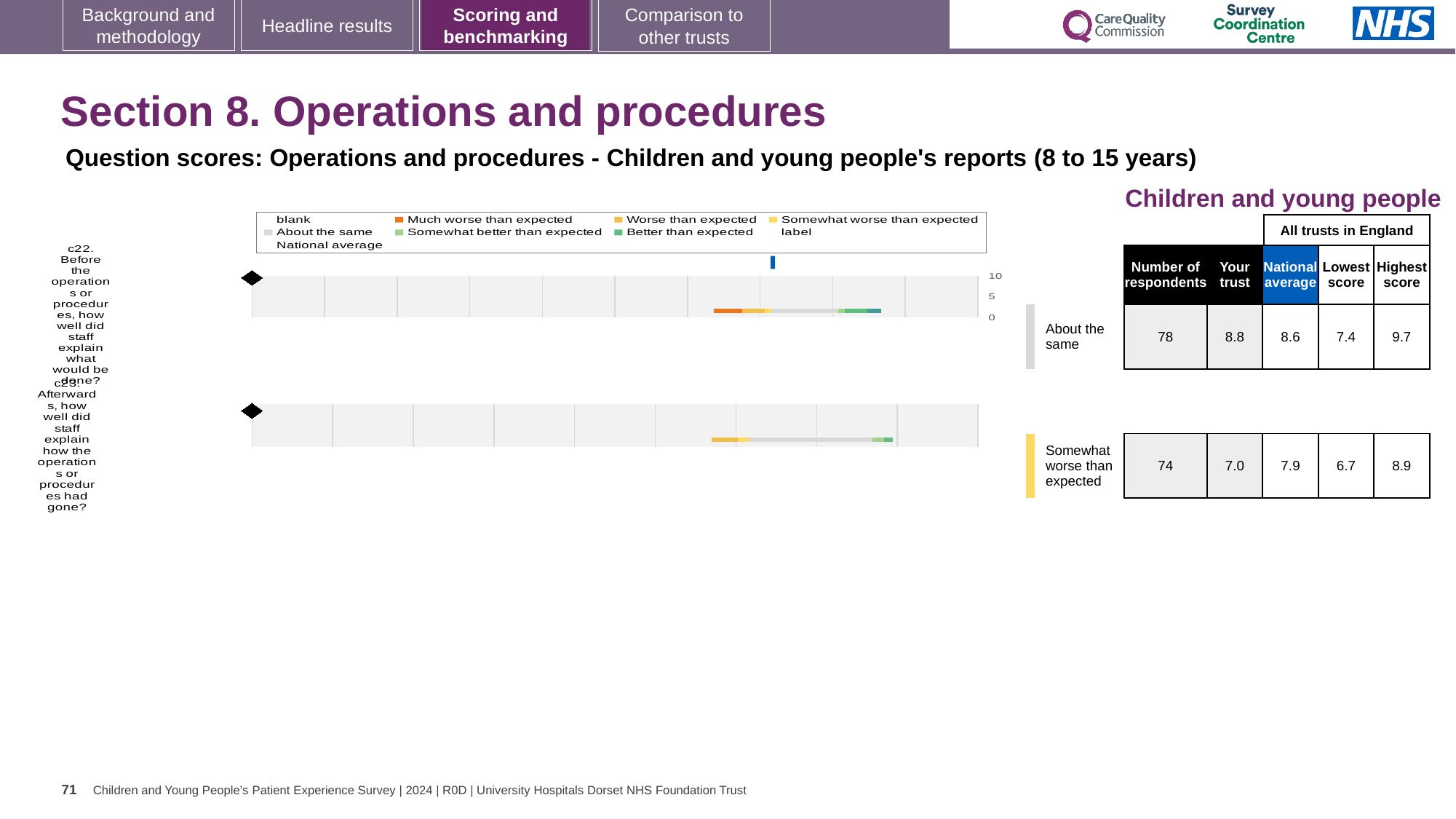
What is the highest score among all trusts in England for c22? 9.7 Which benchmark category is the trust's score for c23 placed in? Somewhat worse than expected What is the difference between the national average and the trust's score for c23? 0.9 What is the national average score for c22? 8.6 By how much does the trust's score for c22 exceed the national average? 0.2 How many survey questions are plotted in the chart? 2 What is the 'Your trust' score for c23? 7.0 For c23, which is larger: the trust's score or the national average? National average What kind of chart is used to show the question scores for c22 and c23? bar chart How many respondents answered c23 (Afterwards, how well did staff explain how the operations or procedures had gone?)? 74 What is the 'Your trust' score for c22 (Before the operations or procedures, how well did staff explain what would be done?)? 8.8 What is the lowest score among all trusts in England for c23? 6.7